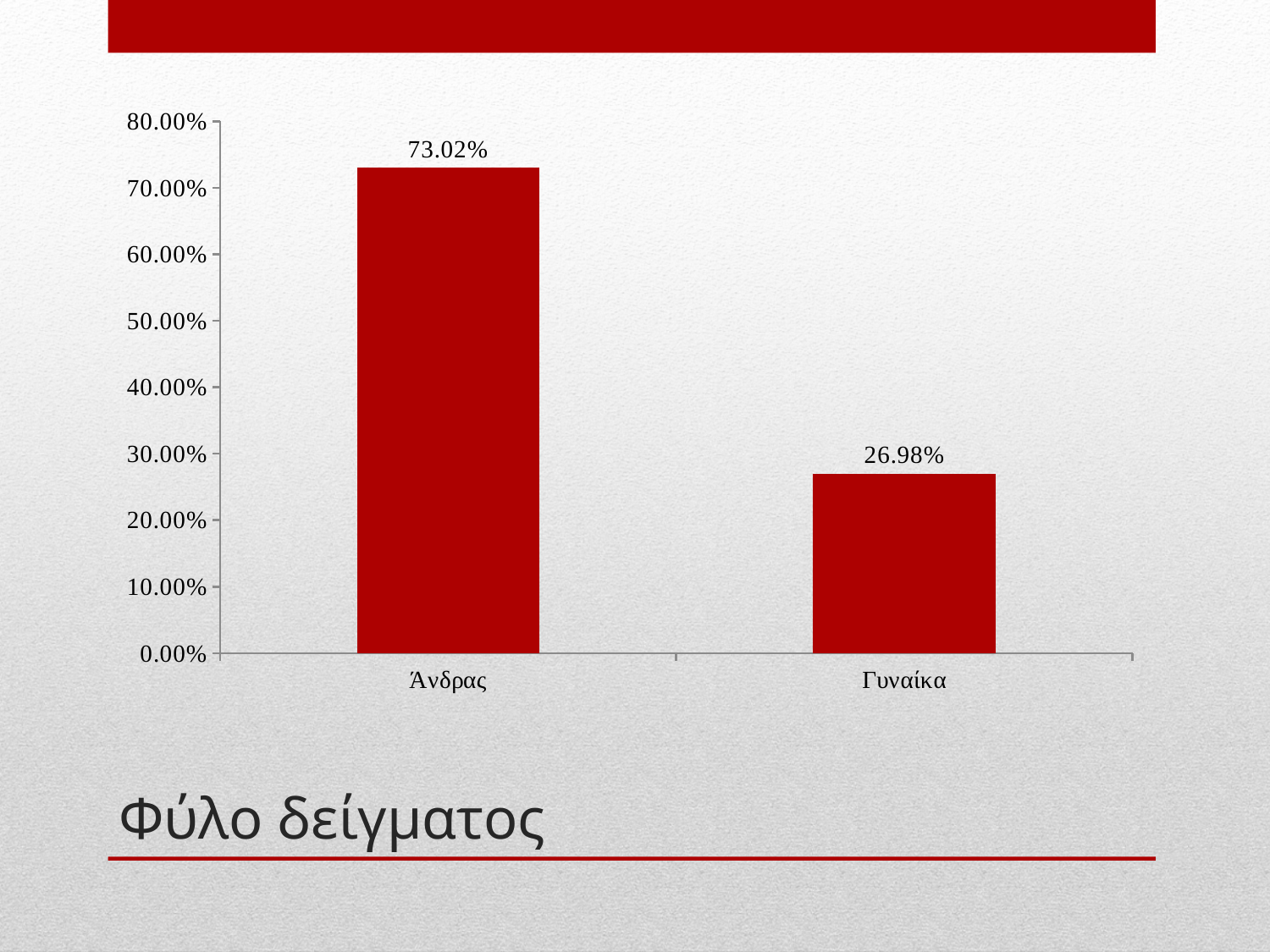
Is the value for Άνδρας greater or less than 70.00%? greater Which category has the lowest value? Γυναίκα What is the value for Άνδρας? 73.02% Is the value for Γυναίκα greater or less than 30.00%? less What is the title of the slide? Φύλο δείγματος What is the value for Γυναίκα? 26.98% Which category has the highest value? Άνδρας What colour are the bars in the chart? dark red What is the difference between the values for Άνδρας and Γυναίκα? 46.04% What kind of chart is shown on the slide? bar chart Which is larger, the value for Άνδρας or the value for Γυναίκα? Άνδρας How many categories are shown on the x axis? 2